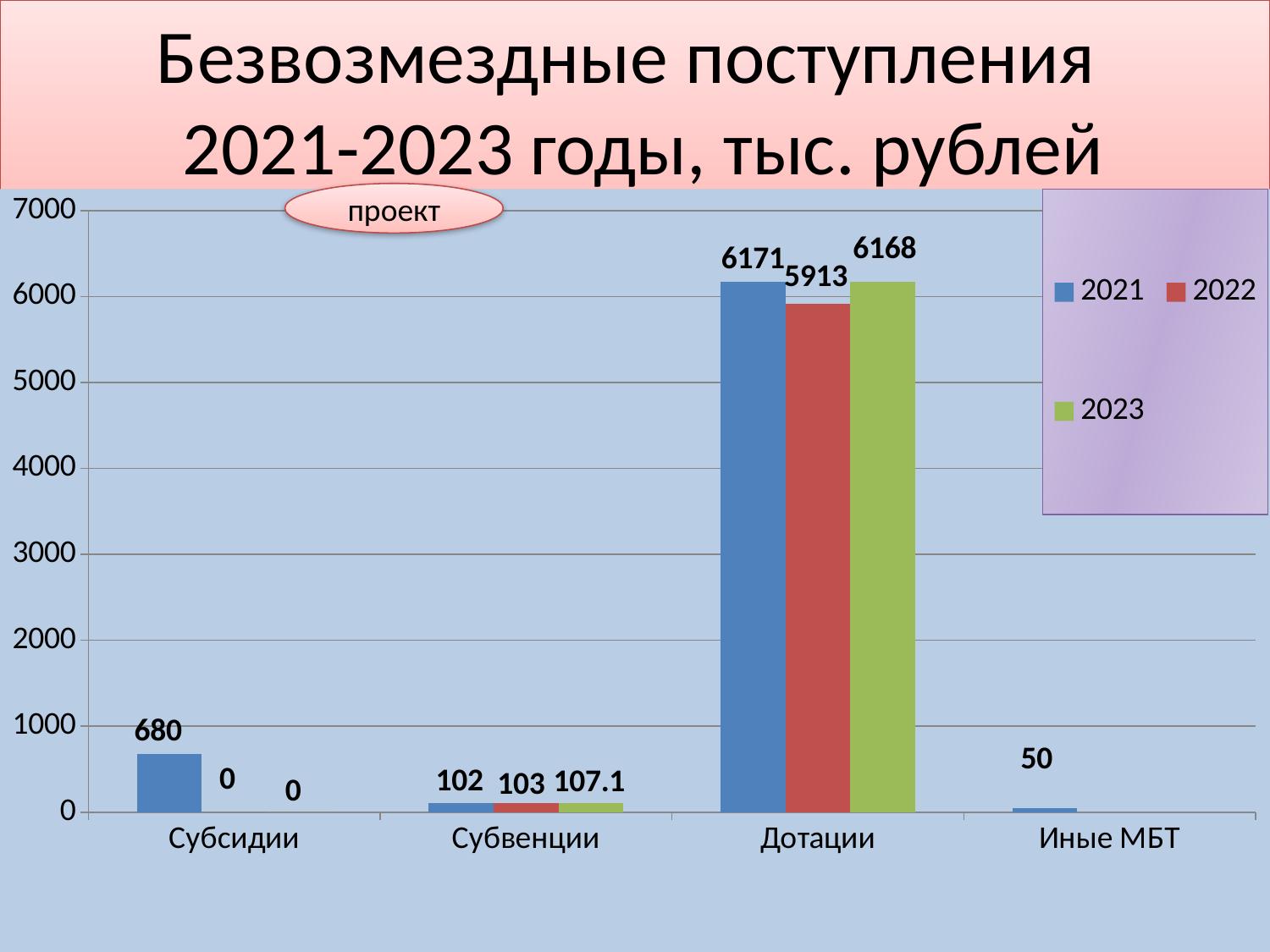
Which category has the highest value in 2022? Дотации How many series does the legend list? 3 Which is larger for Дотации: the 2021 value or the 2023 value? 2021 Is the value for Дотации in 2022 greater or less than 6000? less How many categories are shown on the x axis? 4 What is the value for Дотации in 2021? 6171 What is the difference between the 2021 and 2022 values for Дотации? 258 What is the title of the chart? Безвозмездные поступления 2021-2023 годы, тыс. рублей What kind of chart is shown on the slide? bar chart What is the value for Субвенции in 2023? 107.1 What is the value for Иные МБТ in 2021? 50 What is the value for Субсидии in 2021? 680